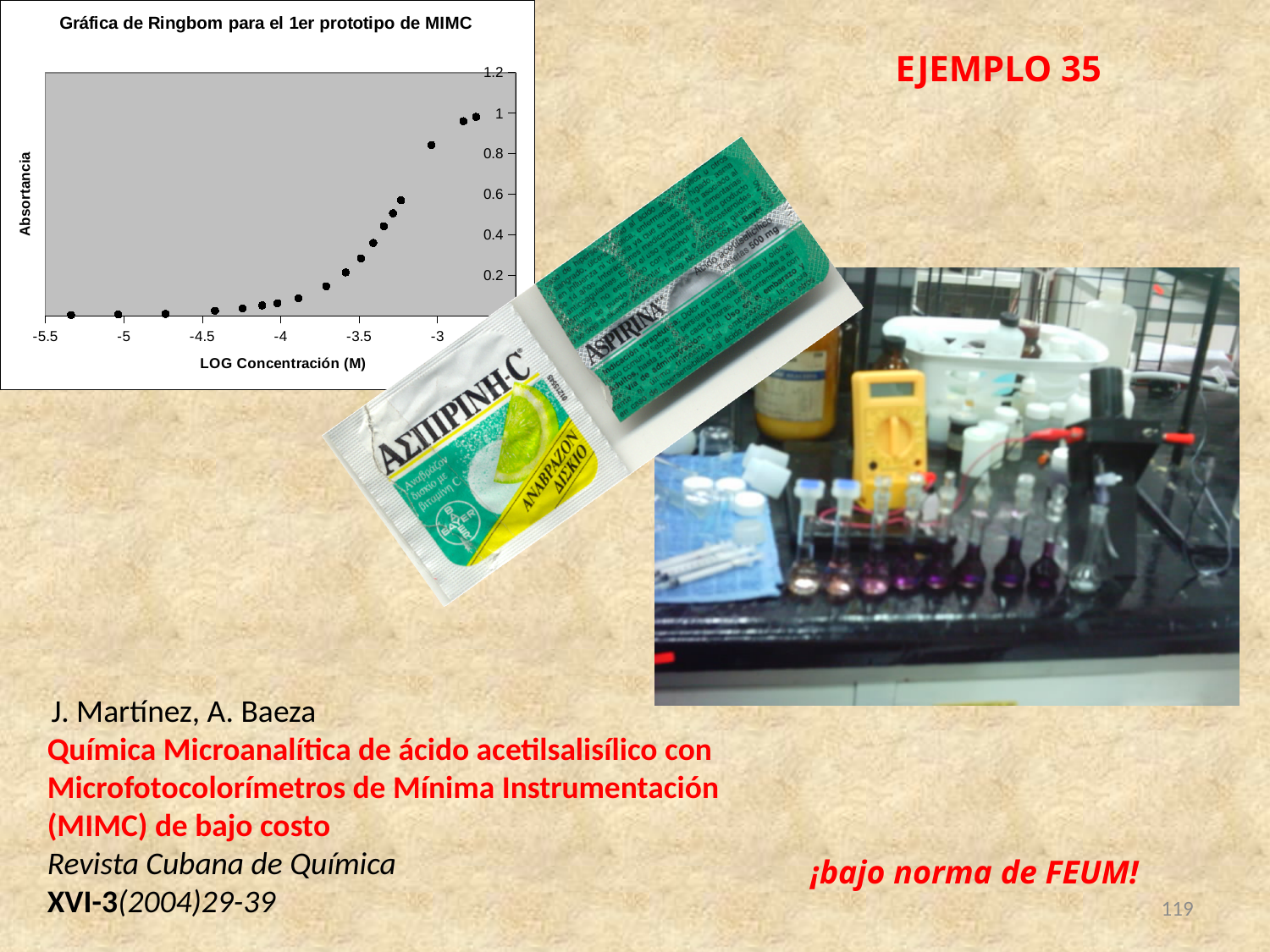
What kind of chart is shown on the slide? scatter plot Do the absorbance values rise or fall as LOG Concentración increases along the x axis? rise Is the absorbance value at LOG Concentración -3.25 greater or less than 0.4? greater Is the absorbance value at LOG Concentración -4 greater or less than 0.2? less What is the title of the chart on the slide? Gráfica de Ringbom para el 1er prototipo de MIMC What is the highest tick value shown on the y axis of the chart? 1.2 Is the absorbance value at LOG Concentración -5 greater or less than 0.2? less At which end of the x axis is the absorbance lowest, the left (-5.5) or the right (-3)? left (-5.5) What is the label of the x axis of the chart? LOG Concentración (M) Which has the higher absorbance: the point at LOG Concentración -3.5 or the point at -4.5? the point at -3.5